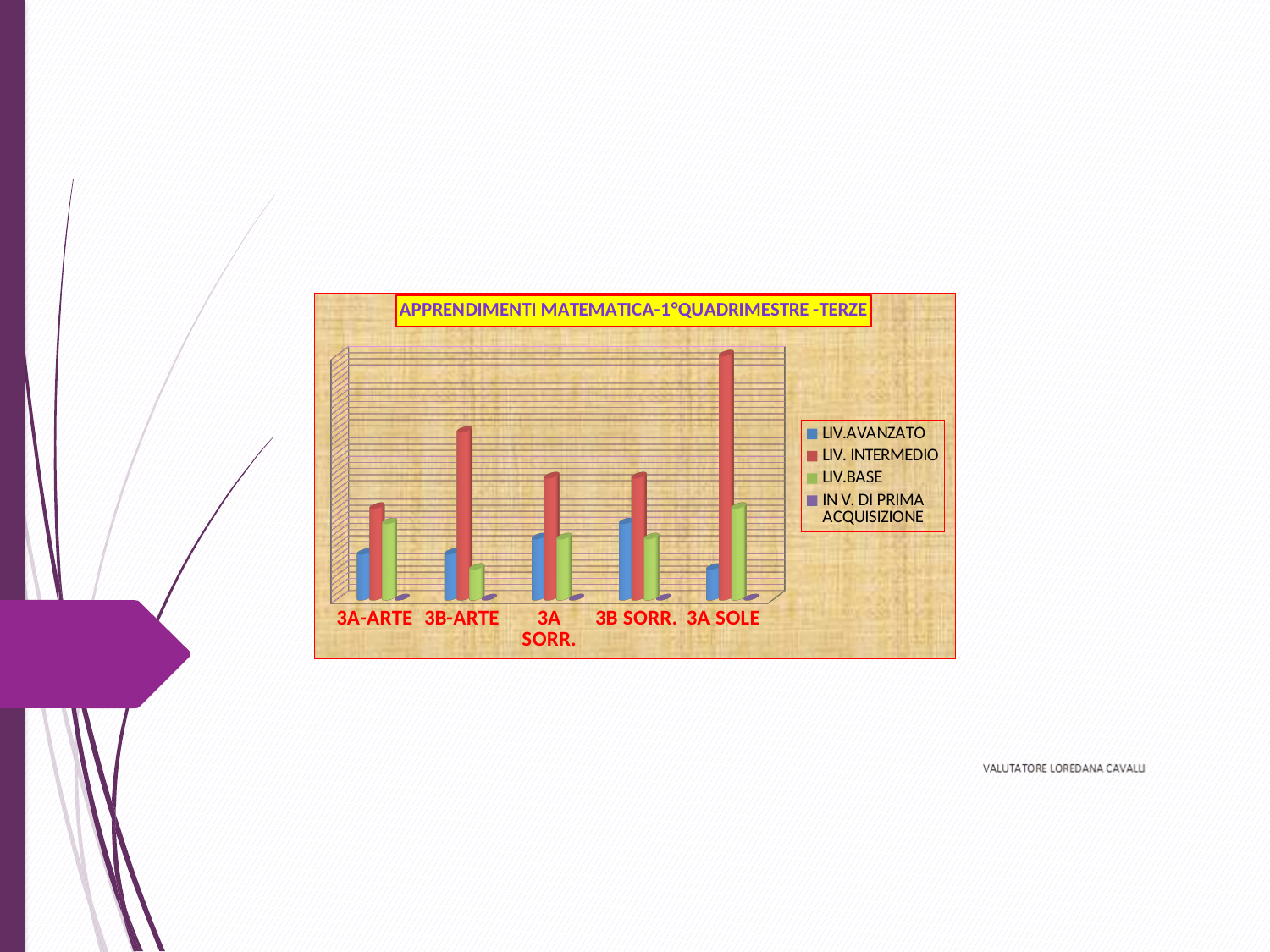
Is the LIV. INTERMEDIO bar larger for 3A SOLE or for 3B-ARTE? 3A SOLE Is the LIV.BASE bar larger for 3A-ARTE or for 3B-ARTE? 3A-ARTE Which class has the lowest LIV.BASE bar? 3B-ARTE How many series does the legend list? 4 Which legend entry is shown in red? LIV. INTERMEDIO Which class has the highest LIV. INTERMEDIO bar? 3A SOLE How many classes (categories) are shown on the x axis? 5 Which class has the highest LIV.AVANZATO bar? 3B SORR. What kind of chart is shown on the slide? bar chart Which series has the smallest bar in every class? IN V. DI PRIMA ACQUISIZIONE Which class has the lowest LIV. INTERMEDIO bar? 3A-ARTE What is the title of the chart? APPRENDIMENTI MATEMATICA-1°QUADRIMESTRE -TERZE